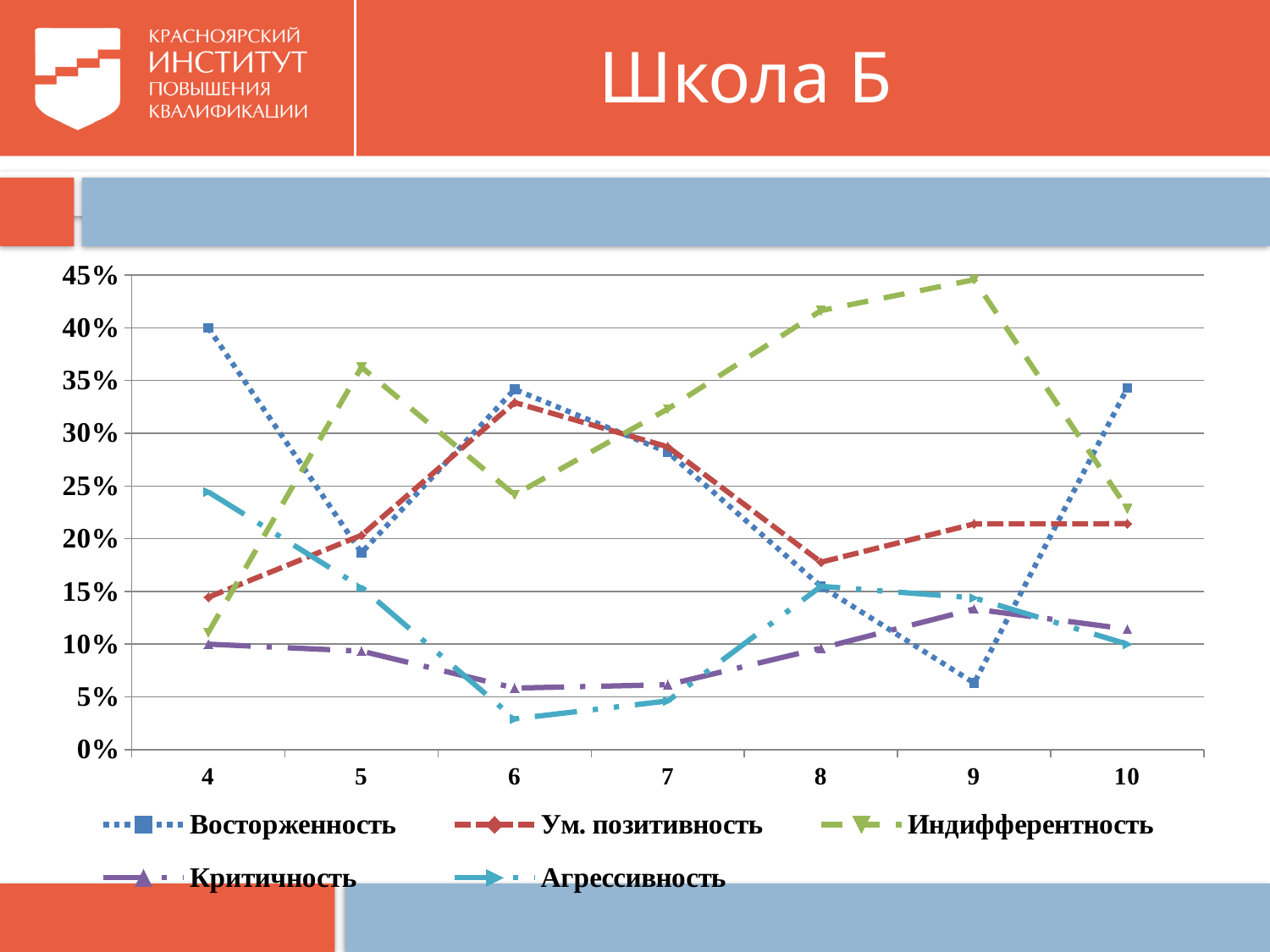
How many series does the legend list? 5 Is the value for Восторженность at 4 greater or less than 35%? greater Does the Индифферентность series rise or fall from 6 to 9? rise How many points are on the x axis of the chart? 7 Is the value for Индифферентность at 8 greater or less than 40%? greater At which x value does the Восторженность series reach its lowest point? 9 At x = 4, which series is larger: Восторженность or Агрессивность? Восторженность What kind of chart is shown on the slide? line chart What is the title of the slide containing the chart? Школа Б At which x value does the Индифферентность series reach its highest point? 9 At x = 5, which series is larger: Индифферентность or Восторженность? Индифферентность Is the value for Агрессивность at 6 greater or less than 5%? less